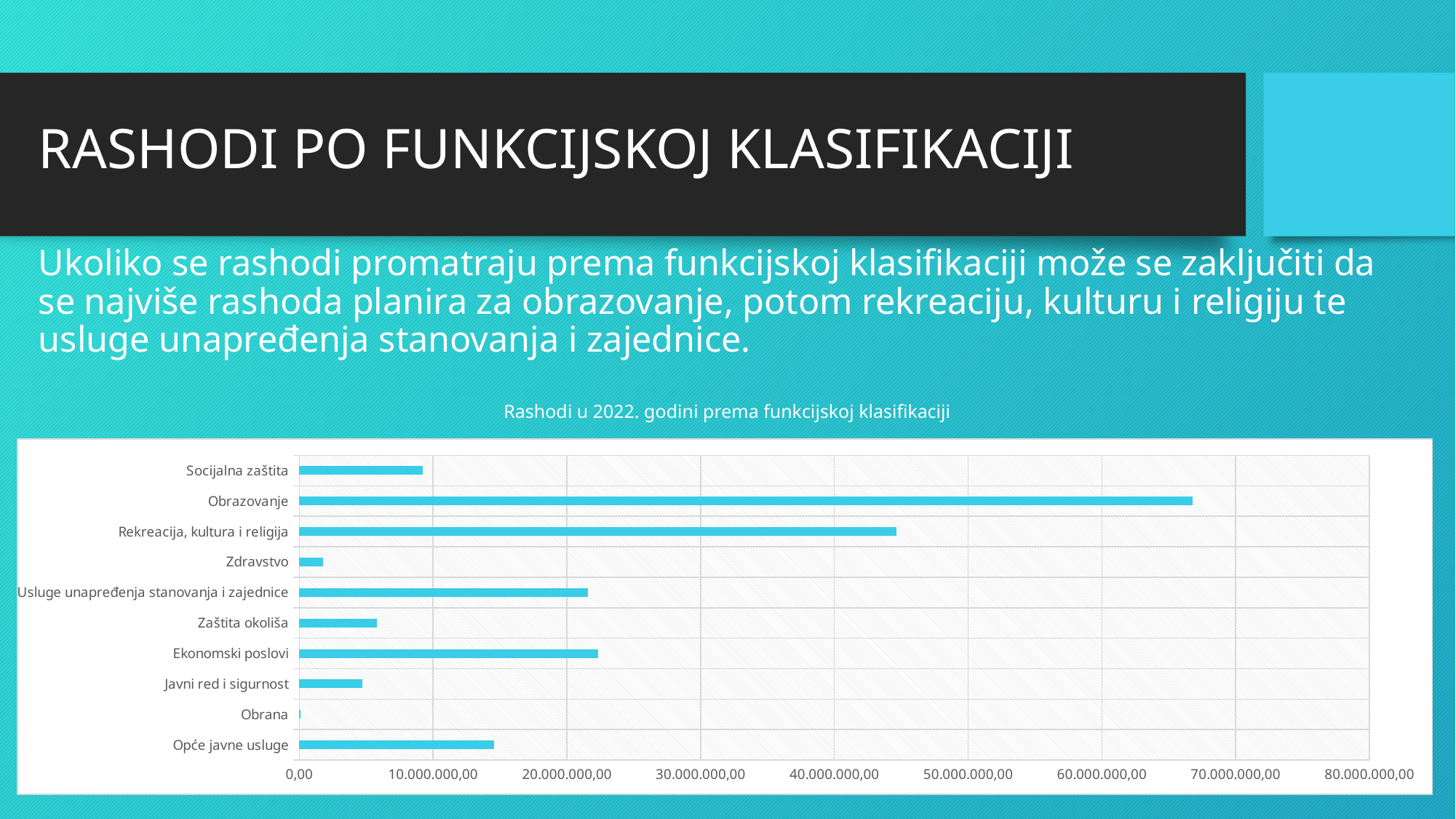
Which category has the highest value in the chart? Obrazovanje Is the value for Rekreacija, kultura i religija greater or less than 40.000.000,00? greater Is the value for Zdravstvo greater or less than 10.000.000,00? less Is the value for Socijalna zaštita greater or less than 10.000.000,00? less What kind of chart is shown on the slide? bar chart Which is larger, the value for Opće javne usluge or the value for Socijalna zaštita? Opće javne usluge Which category has the lowest value in the chart? Obrana What is the title of the chart? Rashodi u 2022. godini prema funkcijskoj klasifikaciji Which is larger, the value for Obrazovanje or the value for Rekreacija, kultura i religija? Obrazovanje How many categories are plotted in the chart? 10